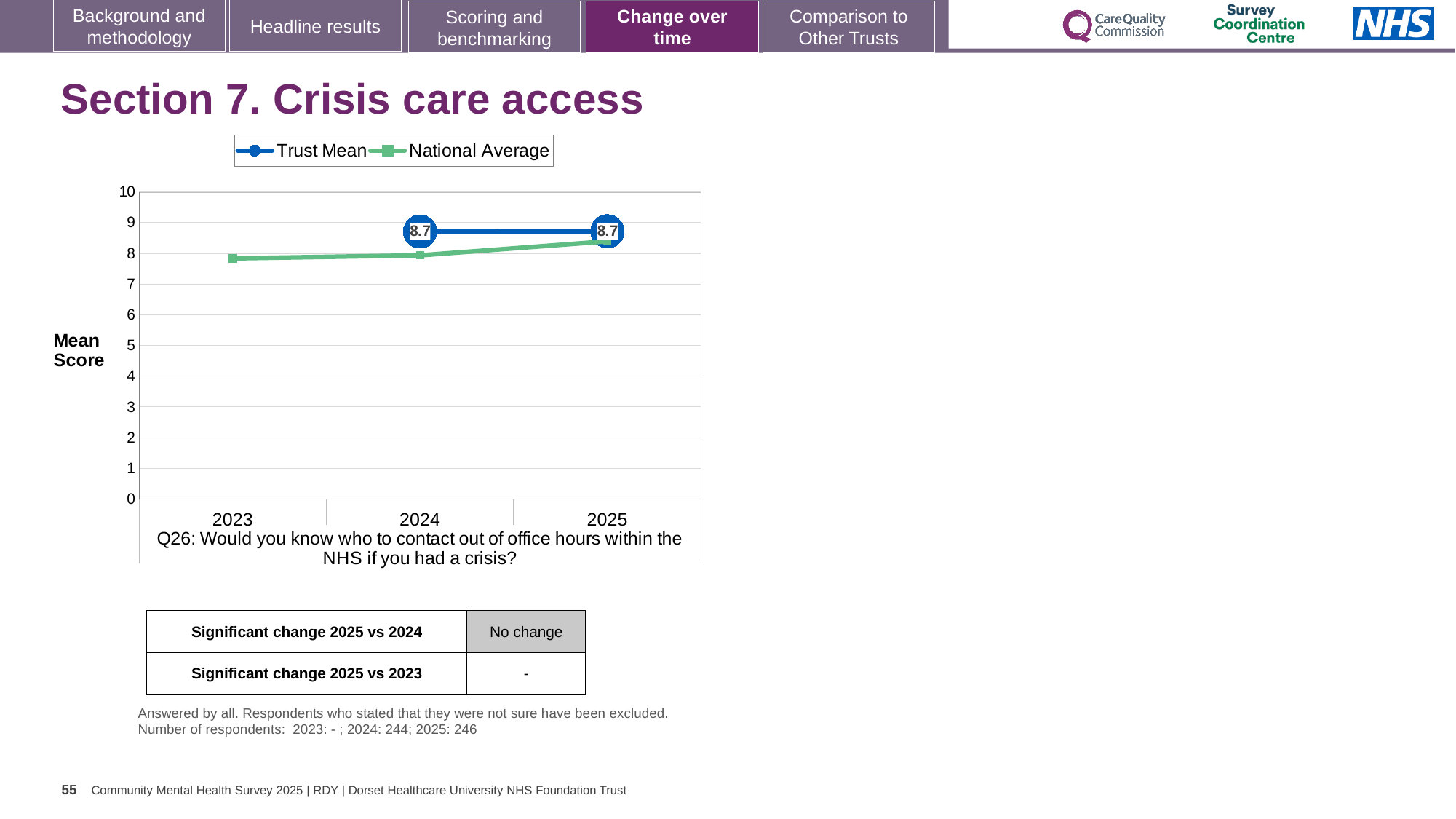
In 2025, which is higher: the Trust Mean or the National Average? Trust Mean Is the National Average value for 2025 greater or less than 9? less Is the National Average value for 2023 greater or less than 7? greater What is the Trust Mean value for 2025? 8.7 How many series does the chart legend list? 2 How many years are shown on the x axis of the chart? 3 What is the label on the y axis of the chart? Mean Score What is the Trust Mean value for 2024? 8.7 For how many years is a Trust Mean data point plotted? 2 Does the National Average rise or fall from 2023 to 2025? Rise What is the difference between the Trust Mean in 2025 and the Trust Mean in 2024? 0 What kind of chart is shown on the slide? Line chart